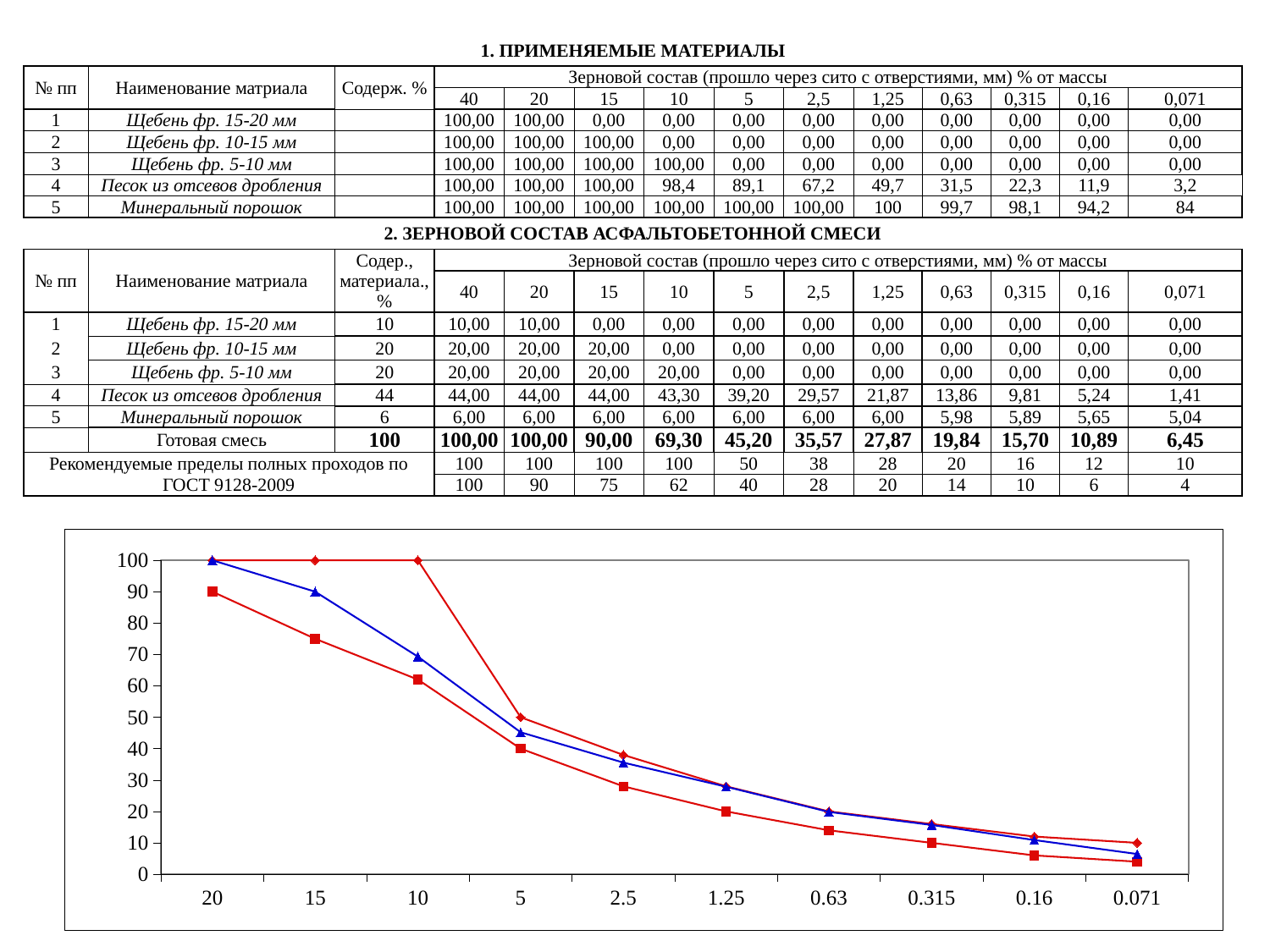
Is the value of the red square-marker line at x = 10 greater or less than 70? less What is the value of the red diamond-marker line at x = 20? 100 What is the highest value shown on the chart's y axis? 100 Do the plotted values rise or fall moving from left to right along the x axis? fall What is the value of the blue triangle-marker line at x = 15? 90 Is the value of the red diamond-marker line at x = 2.5 greater or less than 30? greater At x = 10, which line has the larger value: the red diamond-marker line or the blue triangle-marker line? the red diamond-marker line Is the value of the red square-marker line at x = 0.071 greater or less than 10? less How many lines (data series) are plotted on the chart? 3 How many categories are shown along the x axis of the chart? 10 What kind of chart is shown on the slide? line chart